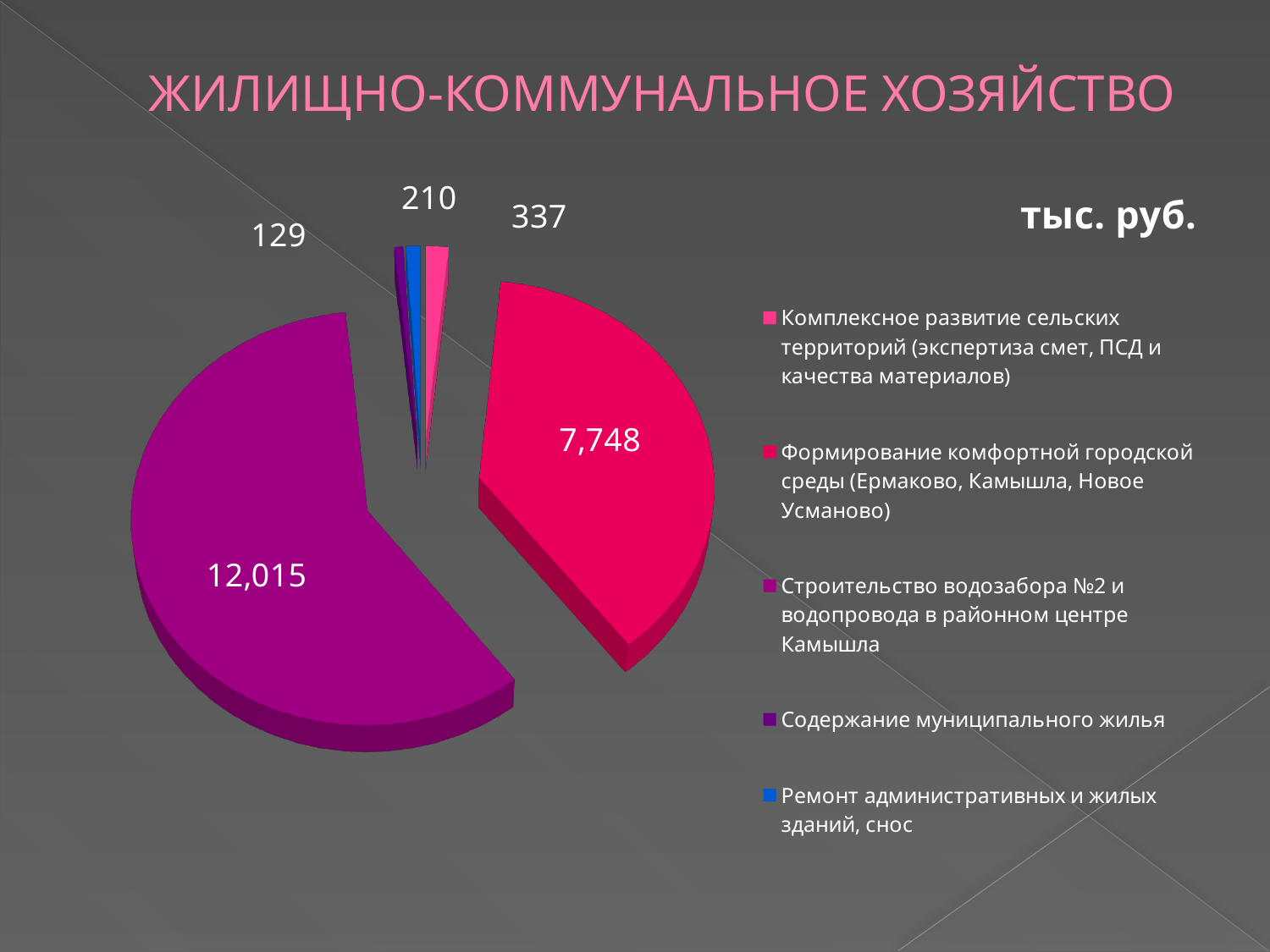
What is the value for «Содержание муниципального жилья»? 129 What type of chart is shown on the slide? Pie chart Which category has the smallest slice of the pie? Содержание муниципального жилья Which is larger: the value for «Ремонт административных и жилых зданий, снос» or for «Содержание муниципального жилья»? Ремонт административных и жилых зданий, снос What is the value for «Строительство водозабора №2 и водопровода в районном центре Камышла»? 12,015 What is the value for «Формирование комфортной городской среды (Ермаково, Камышла, Новое Усманово)»? 7,748 What is the value for «Комплексное развитие сельских территорий (экспертиза смет, ПСД и качества материалов)»? 337 What is the value for «Ремонт административных и жилых зданий, снос»? 210 How many slices does the pie chart have? 5 Which category has the largest slice of the pie? Строительство водозабора №2 и водопровода в районном центре Камышла What is the difference between the values for «Строительство водозабора №2 и водопровода в районном центре Камышла» and «Формирование комфортной городской среды»? 4,267 What unit is indicated for the values in the chart? тыс. руб.